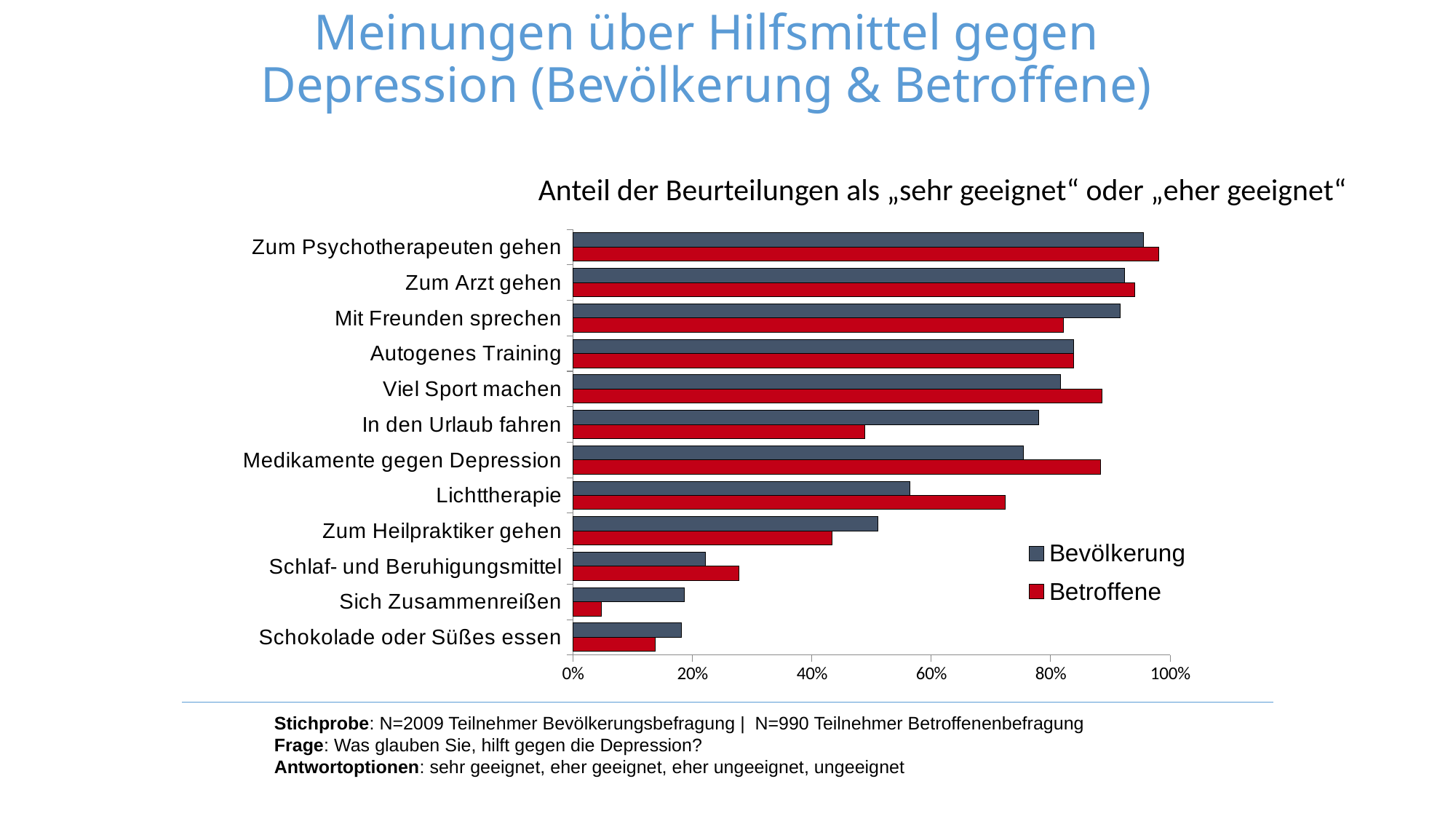
Is the Bevölkerung value for Schlaf- und Beruhigungsmittel greater or less than 40%? less Is the Betroffene value for Medikamente gegen Depression greater or less than 80%? greater Which category has the highest value for Bevölkerung? Zum Psychotherapeuten gehen Which category has the lowest value for Betroffene? Sich Zusammenreißen What colour are the bars for the Betroffene series? red How many categories (Hilfsmittel) are plotted on the chart? 12 Which category has the highest value for Betroffene? Zum Psychotherapeuten gehen How many series does the legend list? 2 What kind of chart is shown on the slide? bar chart For In den Urlaub fahren, which series has the larger value, Bevölkerung or Betroffene? Bevölkerung Is the Betroffene value for In den Urlaub fahren greater or less than 60%? less For Medikamente gegen Depression, which series has the larger value, Bevölkerung or Betroffene? Betroffene